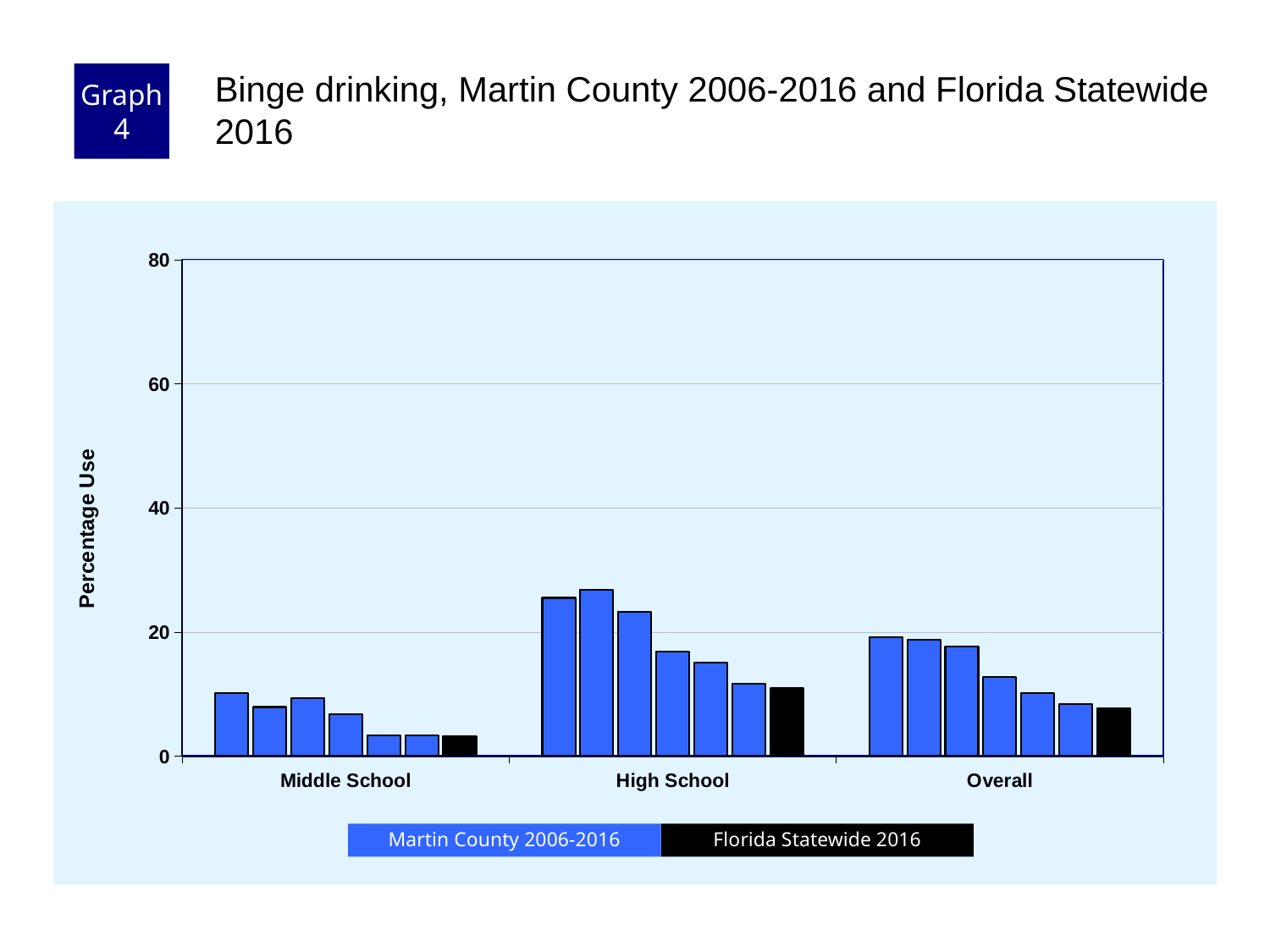
How many school-level categories are shown on the x axis? 3 Is the Florida Statewide 2016 value for High School larger or smaller than the Florida Statewide 2016 value for Middle School? larger Which category has the tallest bars overall? High School Which colour represents Florida Statewide 2016 in the legend? black Within the High School group, do the Martin County bars generally rise or fall from left to right? fall What kind of chart is shown on the slide? bar chart Which category has the shortest bars overall? Middle School Is the Florida Statewide 2016 value for High School greater or less than 20? less How many series does the legend list? 2 Is the tallest Martin County bar for High School greater or less than 20? greater What is the label on the y axis? Percentage Use Is the Florida Statewide 2016 value for Overall greater or less than 20? less